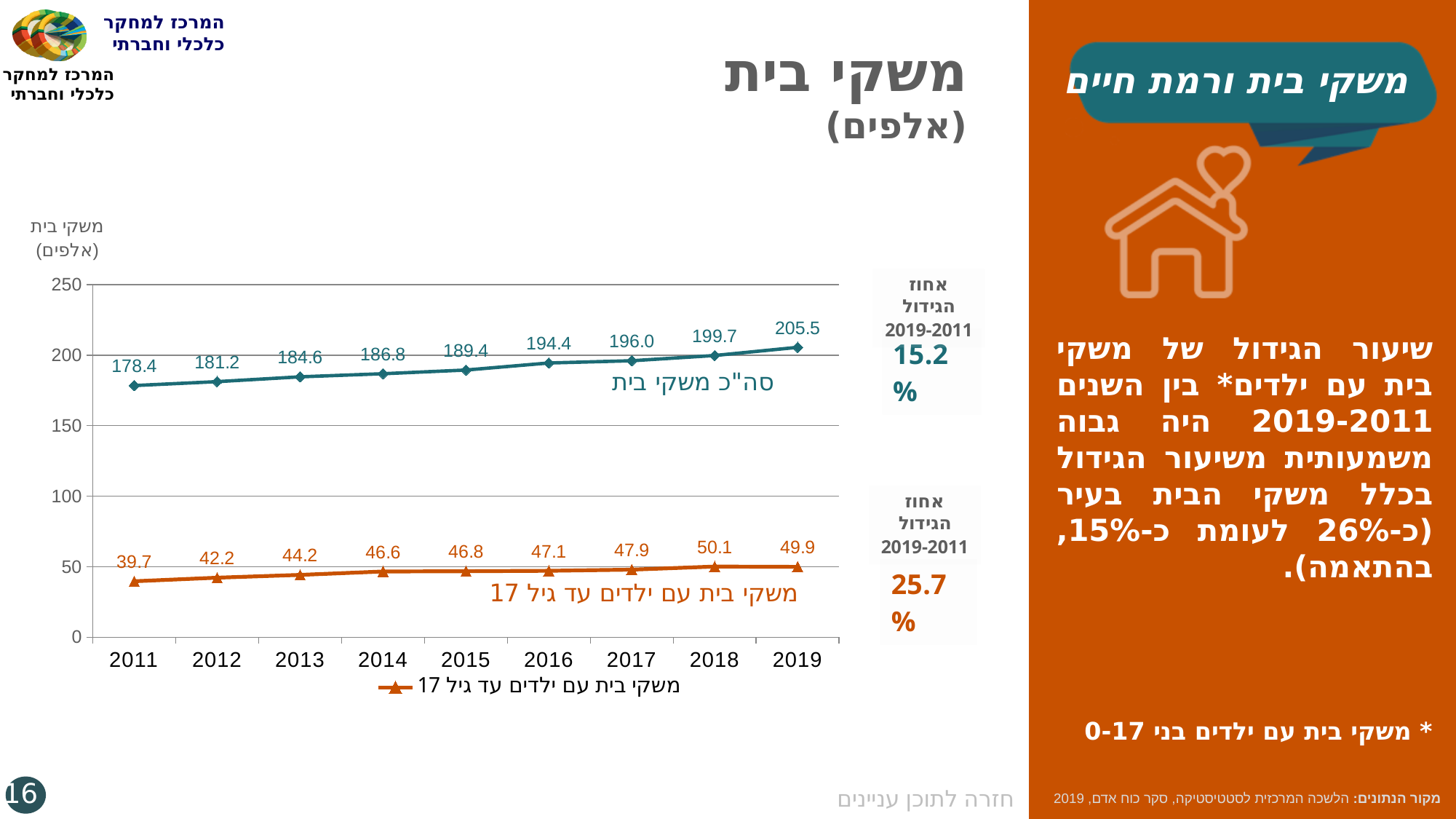
What is the difference between the סה"כ משקי בית values in 2019 and 2011? 27.1 What is the value for סה"כ משקי בית in 2011? 178.4 How many years are plotted on the x axis? 9 What is the value for משקי בית עם ילדים עד גיל 17 in 2018? 50.1 Which is larger: the value for משקי בית עם ילדים עד גיל 17 in 2018 or in 2019? 2018 In which year is the value for סה"כ משקי בית the lowest? 2011 In which year is the value for משקי בית עם ילדים עד גיל 17 the highest? 2018 What is the value for סה"כ משקי בית in 2019? 205.5 What type of chart is shown on the slide? line chart Does the סה"כ משקי בית series rise or fall from 2011 to 2019? rise What growth percentage for 2019-2011 is shown next to the משקי בית עם ילדים עד גיל 17 line? 25.7% What is the value for משקי בית עם ילדים עד גיל 17 in 2015? 46.8